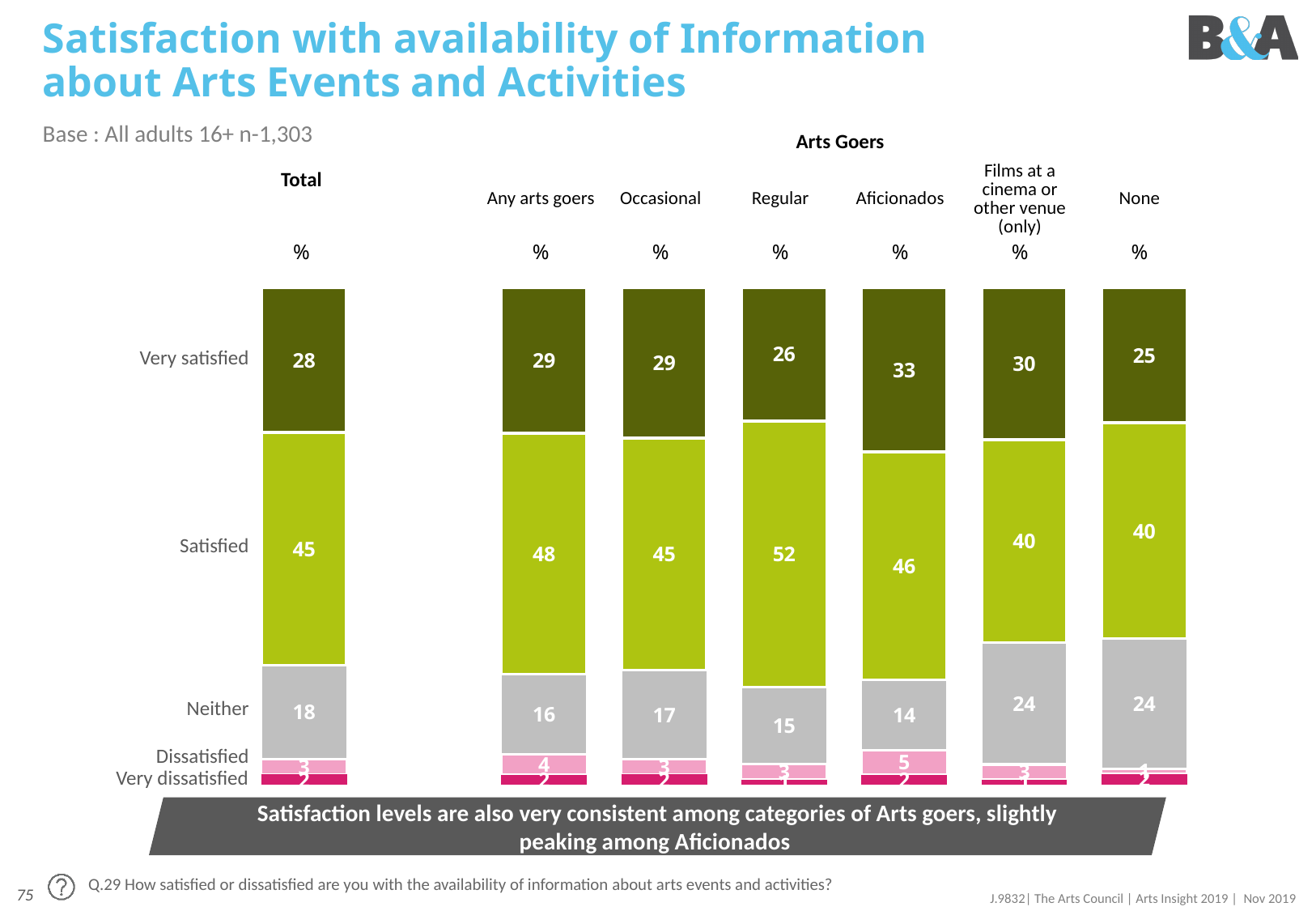
Which has a larger Neither value: Films at a cinema or other venue (only) or Regular? Films at a cinema or other venue (only) What type of chart is shown on the slide? Stacked bar chart What is the Satisfied value for Regular arts goers? 52 Which category has the lowest Very satisfied value? None What is the Neither value for the Total bar? 18 What is the difference between the Very satisfied values for Aficionados and Regular? 7 What is the difference between the Satisfied values for Any arts goers and Occasional? 3 What percentage of Aficionados are Very satisfied with the availability of information about arts events? 33 How many bars (categories) are shown in the chart? 7 Which category has the highest Satisfied value? Regular What is the Neither value for the None category? 24 Which category has the highest Very satisfied value? Aficionados